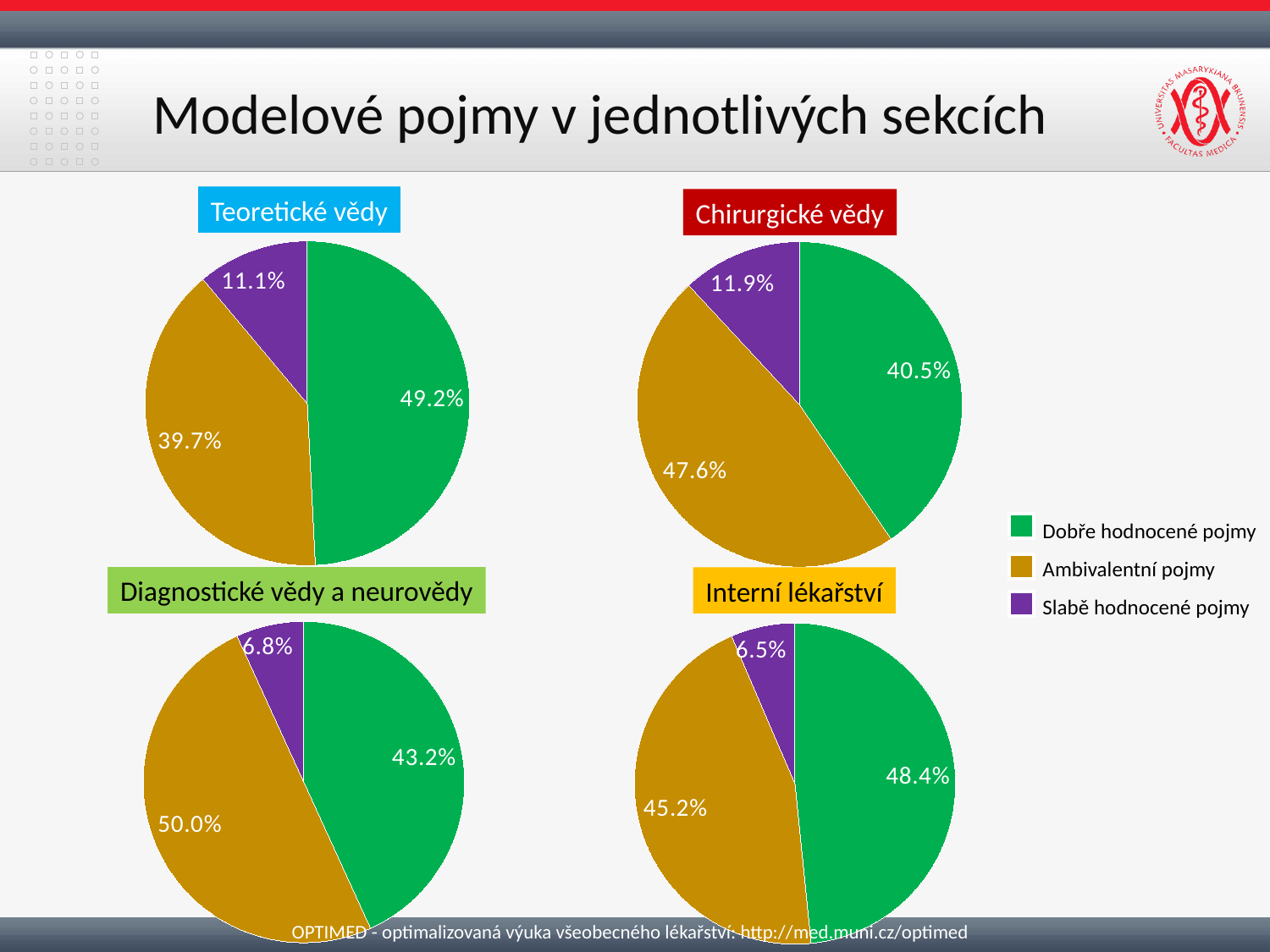
Which colour represents Slabě hodnocené pojmy in the legend? Purple In the Teoretické vědy chart, what share is Dobře hodnocené pojmy? 49.2% In the Interní lékařství chart, which is larger: Dobře hodnocené pojmy or Ambivalentní pojmy? Dobře hodnocené pojmy What kind of chart is used for Teoretické vědy? Pie chart In the Chirurgické vědy chart, what share is Ambivalentní pojmy? 47.6% How many categories does the legend list? 3 In the Diagnostické vědy a neurovědy chart, what share is Slabě hodnocené pojmy? 6.8% In the Diagnostické vědy a neurovědy chart, what is the difference between the Ambivalentní pojmy and Dobře hodnocené pojmy shares? 6.8% In the Chirurgické vědy chart, which category has the largest slice? Ambivalentní pojmy How many slices does the Chirurgické vědy pie chart have? 3 In the Teoretické vědy chart, which category has the smallest slice? Slabě hodnocené pojmy